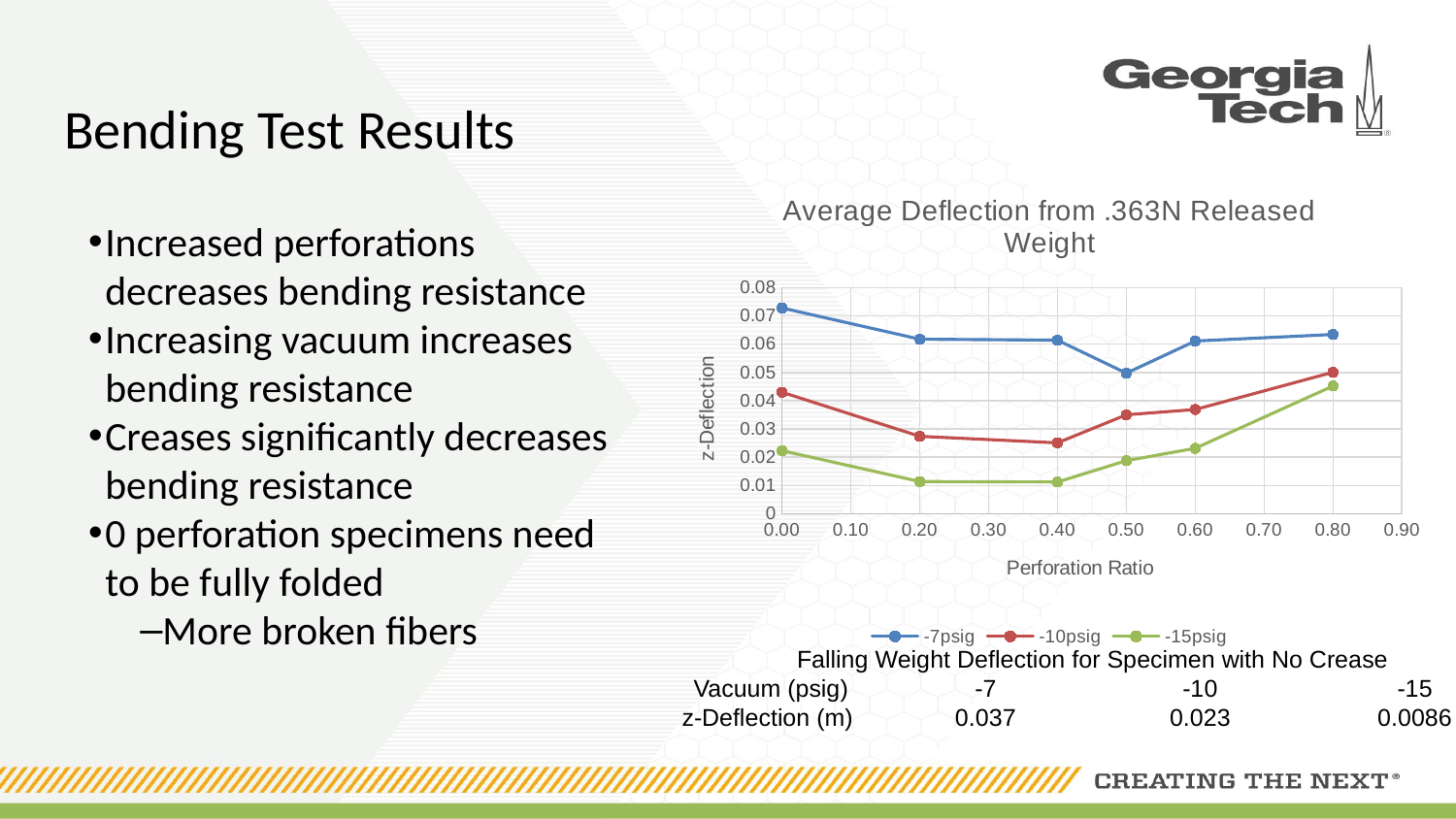
How many data points are plotted for the -7psig series? 6 At which perforation ratio does the -7psig series reach its lowest value? 0.50 How many series does the chart legend list? 3 Is the value for -7psig at perforation ratio 0.80 greater or less than 0.06? greater Is the value for -10psig at perforation ratio 0.40 greater or less than 0.03? less What is the title of the chart? Average Deflection from .363N Released Weight Which series has the lowest z-Deflection values across the chart? -15psig Which series has the highest z-Deflection values across the chart? -7psig What kind of chart is shown on the slide? line chart Do the -15psig values rise or fall as the perforation ratio goes from 0.40 to 0.80? rise What is the label of the x axis of the chart? Perforation Ratio At which perforation ratio does the -15psig series reach its highest value? 0.80